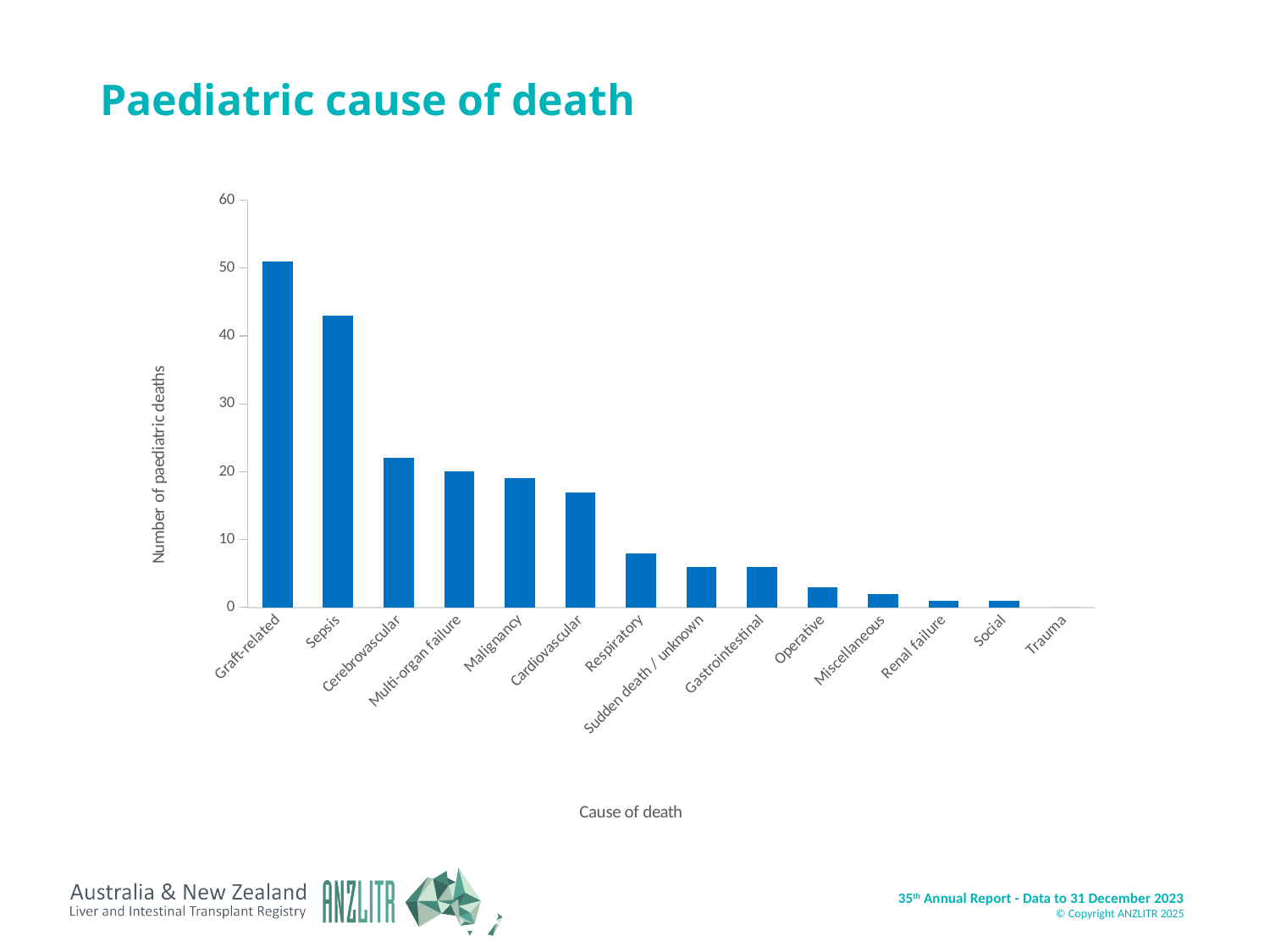
Which has more paediatric deaths, Sepsis or Cerebrovascular? Sepsis What kind of chart is shown on the slide? bar chart Is the value for Cerebrovascular greater or less than 30? less Is the value for Cardiovascular greater or less than 20? less Which cause of death has the highest number of paediatric deaths? Graft-related How many causes of death are shown on the x axis? 14 What is the label on the y axis? Number of paediatric deaths Which cause of death has the lowest number of paediatric deaths? Trauma What is the title of the chart? Paediatric cause of death Is the value for Respiratory greater or less than 10? less Do the values rise or fall moving from left to right along the x axis? fall